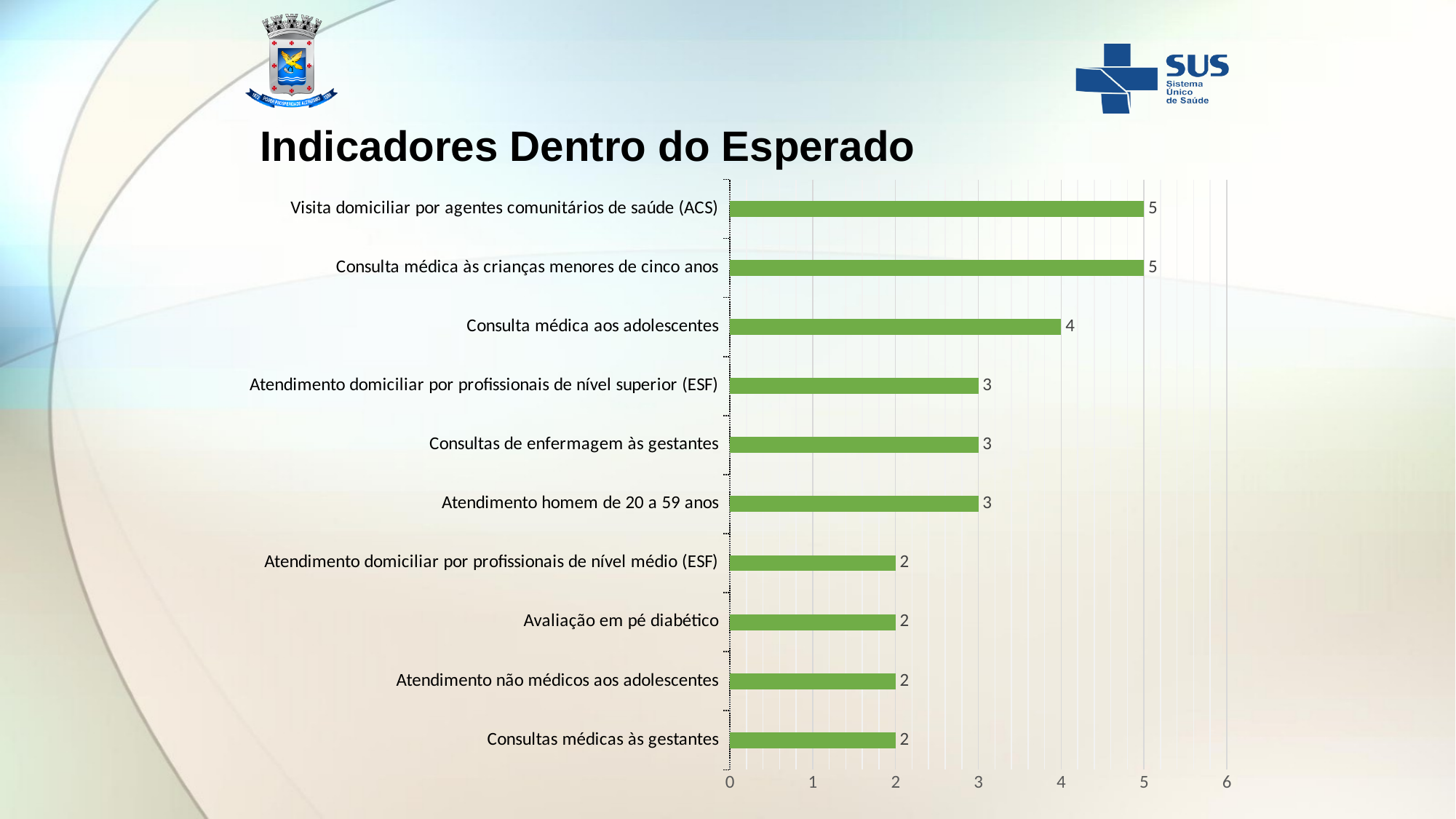
What is the difference between the values for "Consulta médica às crianças menores de cinco anos" and "Atendimento não médicos aos adolescentes"? 3 What is the value for "Visita domiciliar por agentes comunitários de saúde (ACS)"? 5 What is the value for "Consulta médica aos adolescentes"? 4 Is the value for "Consulta médica aos adolescentes" greater or less than 3? greater What is the highest value shown on the horizontal axis? 6 What is the title of the chart? Indicadores Dentro do Esperado What kind of chart is shown on the slide? Bar chart Which is larger: the value for "Consulta médica aos adolescentes" or the value for "Atendimento domiciliar por profissionais de nível superior (ESF)"? Consulta médica aos adolescentes What is the value for "Avaliação em pé diabético"? 2 How many categories are shown in the chart? 10 Which category has the lowest value among "Consulta médica aos adolescentes", "Consultas de enfermagem às gestantes" and "Consultas médicas às gestantes"? Consultas médicas às gestantes What is the value for "Atendimento homem de 20 a 59 anos"? 3